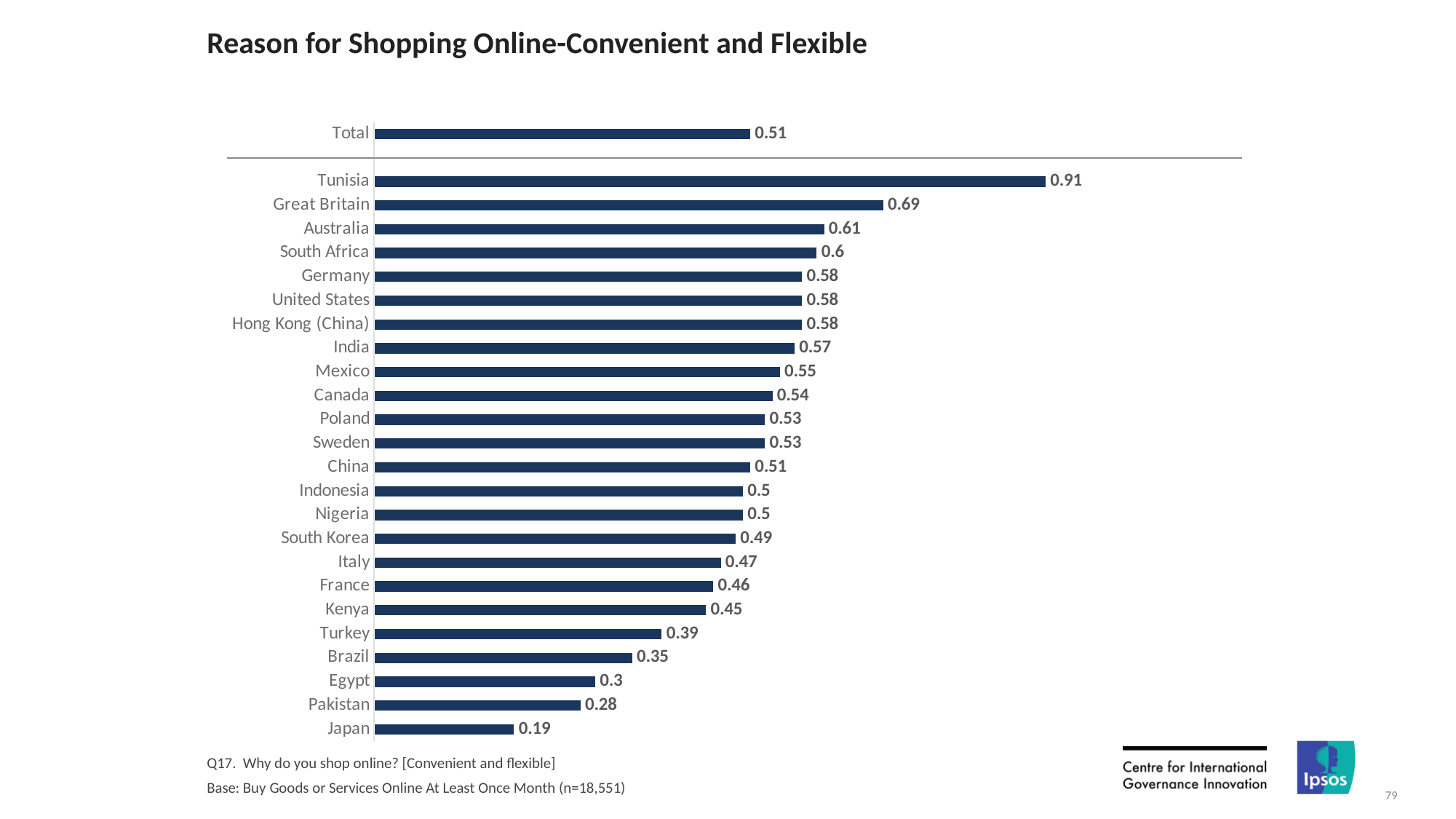
How many countries are listed below the Total bar? 24 What is the difference between the values for Tunisia and Great Britain? 0.22 What is the value for Tunisia? 0.91 What is the title of the chart? Reason for Shopping Online-Convenient and Flexible Which country has the highest value? Tunisia What is the difference between the values for Brazil and Egypt? 0.05 What is the value for Canada? 0.54 What kind of chart is shown on the slide? Bar chart What is the value for Japan? 0.19 Which is larger, the value for Australia or the value for Mexico? Australia What is the value for Total? 0.51 Which country has the lowest value? Japan